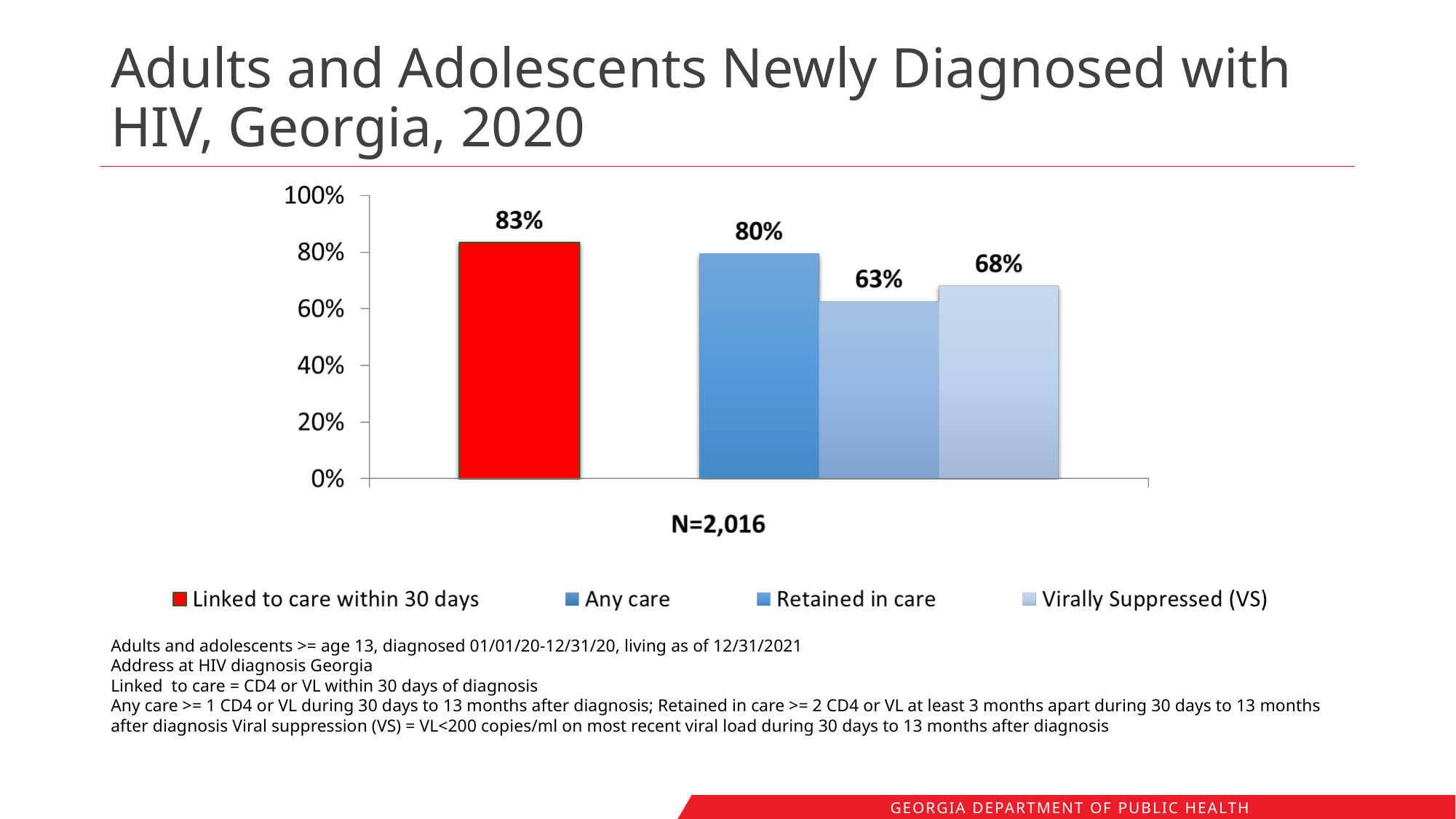
What is the value for Virally Suppressed (VS)? 68% What kind of chart is shown on the slide? Bar chart Which series has the lowest value? Retained in care Which is larger, Virally Suppressed (VS) or Retained in care? Virally Suppressed (VS) What is the difference between the Linked to care within 30 days value and the Virally Suppressed (VS) value? 15% What is the difference between the Any care value and the Retained in care value? 17% How many series does the legend list? 4 What percentage of adults and adolescents were linked to care within 30 days? 83% Which series has the highest value? Linked to care within 30 days What is the value for Any care? 80% What is the N value shown below the chart? N=2,016 What is the value for Retained in care? 63%